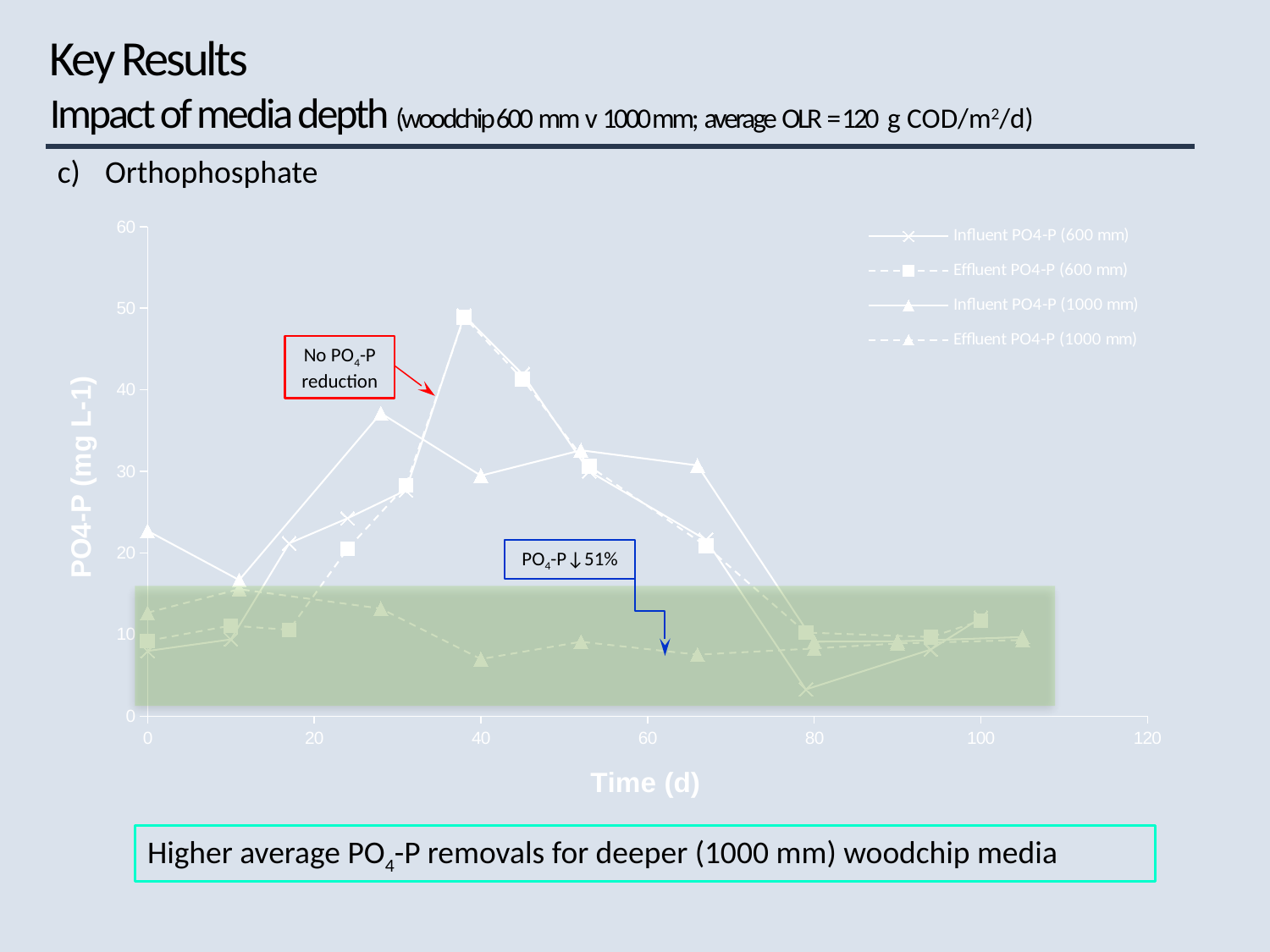
Between about day 40 and day 80, does the Effluent PO4-P (600 mm) series rise or fall? Fall What are the four series listed in the chart legend? Influent PO4-P (600 mm), Effluent PO4-P (600 mm), Influent PO4-P (1000 mm), Effluent PO4-P (1000 mm) What kind of chart is shown on the slide? Line chart At around day 40, which series has the lowest value? Effluent PO4-P (1000 mm) How many labelled tick marks are on the Time (d) axis? 7 Is the value of Influent PO4-P (1000 mm) at day 0 greater or less than 20? greater Is the value of Influent PO4-P (600 mm) at around day 80 greater or less than 10? less What is the title of the chart's y axis? PO4-P (mg L-1) Is the value of Effluent PO4-P (1000 mm) at around day 40 greater or less than 10? less How many series does the chart legend list? 4 At around day 40, which is larger: Effluent PO4-P (600 mm) or Effluent PO4-P (1000 mm)? Effluent PO4-P (600 mm)